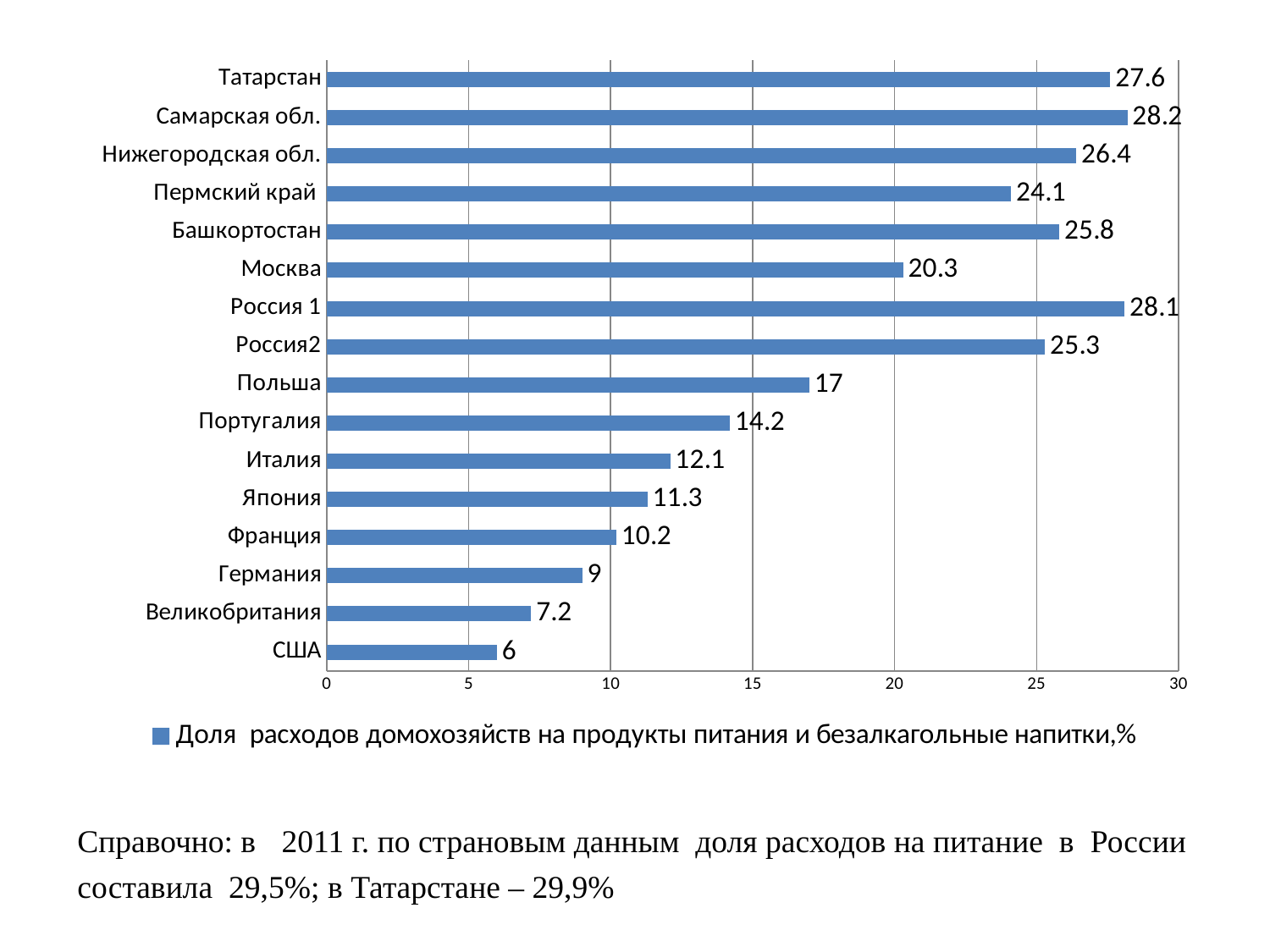
Which is larger, the value for Пермский край or the value for Башкортостан? Башкортостан What is the value for Татарстан? 27.6 How many categories are shown in the chart? 16 What is the difference between the values for Польша and Португалия? 2.8 What is the difference between the values for Татарстан and США? 21.6 Which category has the lowest value? США Is the value for Япония greater or less than 10? greater What kind of chart is shown on the slide? bar chart What is the value for Германия? 9 How many series does the legend list? 1 What is the value for Москва? 20.3 What is the legend entry of the series shown in the chart? Доля расходов домохозяйств на продукты питания и безалкагольные напитки,%